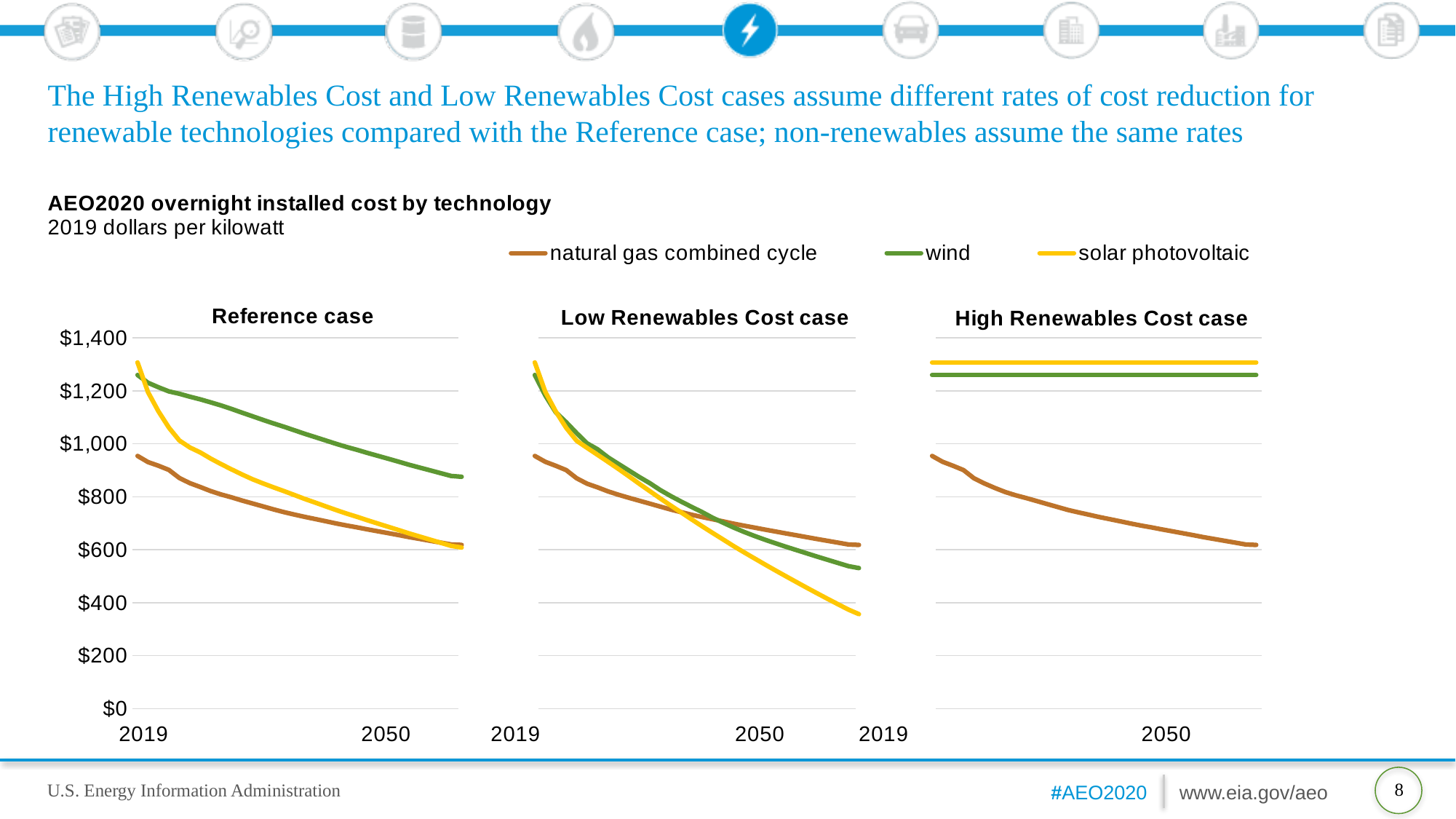
In the Reference case chart, is the value for wind in 2019 greater or less than $1,200? greater In the Reference case chart, does the solar photovoltaic line rise or fall from 2019 to 2050? fall How many series does the legend list? 3 In the Low Renewables Cost case chart, is the value for solar photovoltaic at the end of the projection greater or less than $400? less In the Reference case chart, is the value for natural gas combined cycle at the end of the projection greater or less than $800? less In the High Renewables Cost case chart, which is higher at the end of the projection, solar photovoltaic or natural gas combined cycle? solar photovoltaic In the Low Renewables Cost case chart, which is higher at the end of the projection, wind or solar photovoltaic? wind What unit is given for the values in the charts? 2019 dollars per kilowatt In the High Renewables Cost case chart, does the wind line rise, fall, or stay flat from 2019 to 2050? stay flat What kind of chart is the Reference case chart? line chart In the Reference case chart, which series has the lowest value in 2019? natural gas combined cycle